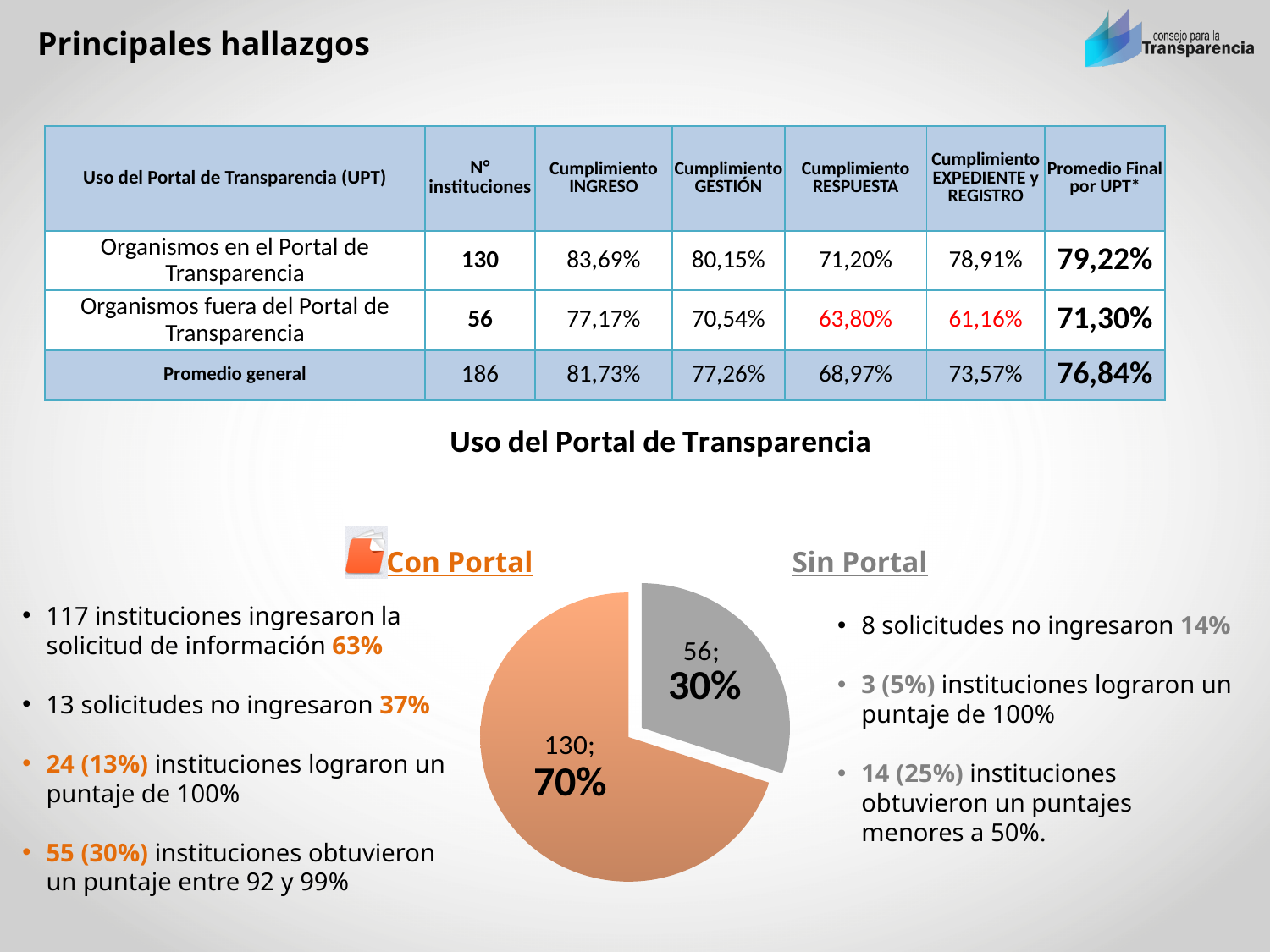
How many slices does the pie chart have? 2 What kind of chart is shown under the heading 'Uso del Portal de Transparencia'? pie chart What is the total number of institutions represented in the pie chart? 186 Which slice of the pie chart is the smallest? Sin Portal In the pie chart, what number of institutions is shown for the 'Con Portal' slice? 130 What share of the pie does the 'Con Portal' slice represent? 70% What share of the pie does the 'Sin Portal' slice represent? 30% What is the title shown above the pie chart? Uso del Portal de Transparencia Which slice of the pie chart is the largest? Con Portal What is the difference between the number of institutions in the 'Con Portal' slice and the 'Sin Portal' slice? 74 What colour is the 'Con Portal' slice of the pie chart? orange In the pie chart, what number of institutions is shown for the 'Sin Portal' slice? 56